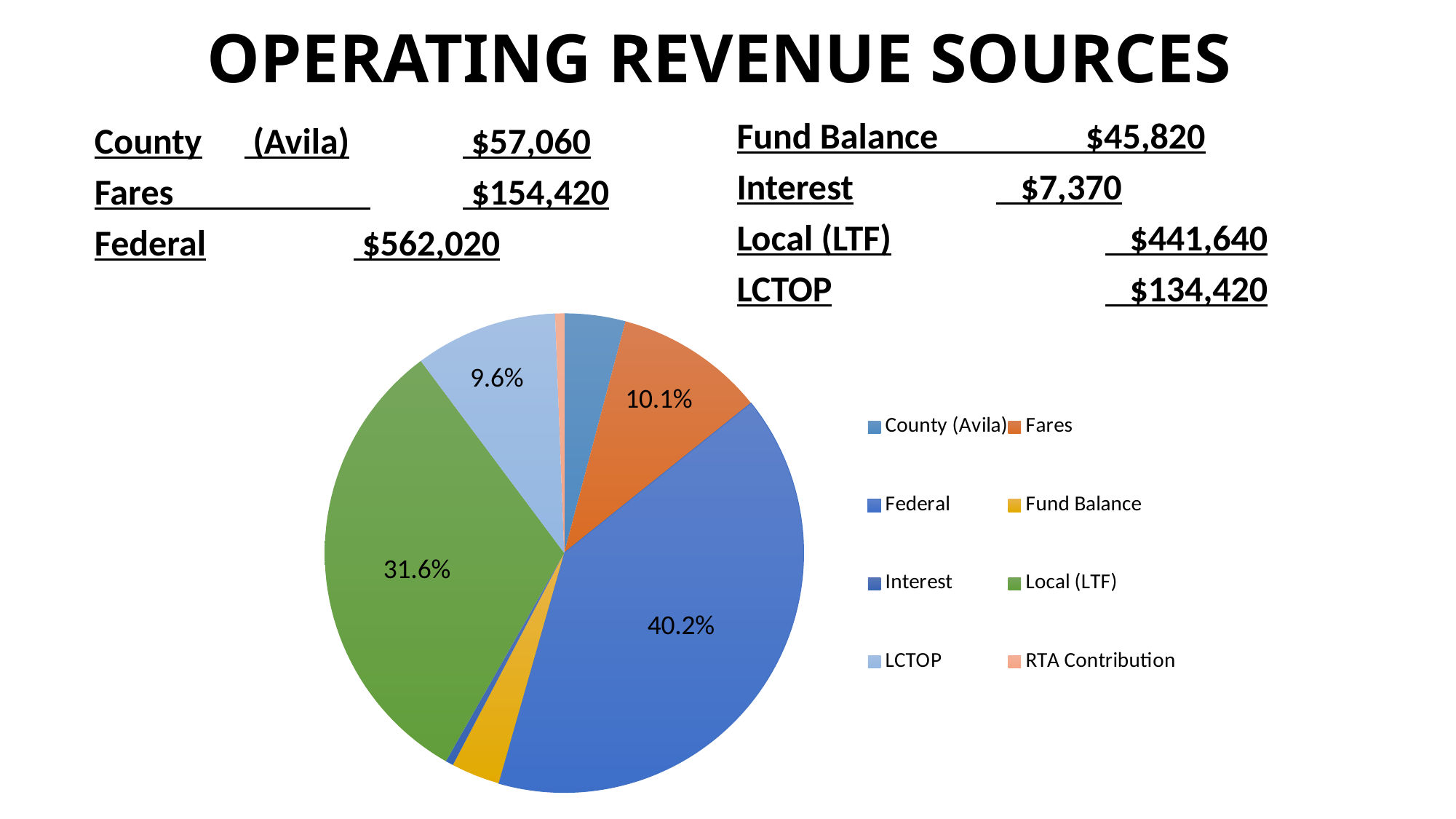
What colour is the Local (LTF) slice in the pie chart? green What is the title of the slide containing the pie chart? OPERATING REVENUE SOURCES What share of the pie does Local (LTF) account for? 31.6% What is the difference in percentage points between the Federal slice and the Local (LTF) slice? 8.6 Which category has the largest slice of the pie? Federal Which slice is larger, Local (LTF) or Fares? Local (LTF) Which slice is larger, Federal or Local (LTF)? Federal What share of the pie does Fares account for? 10.1% How many categories does the legend of the pie chart list? 8 What kind of chart is shown on the slide? pie chart What share of the pie does LCTOP account for? 9.6%